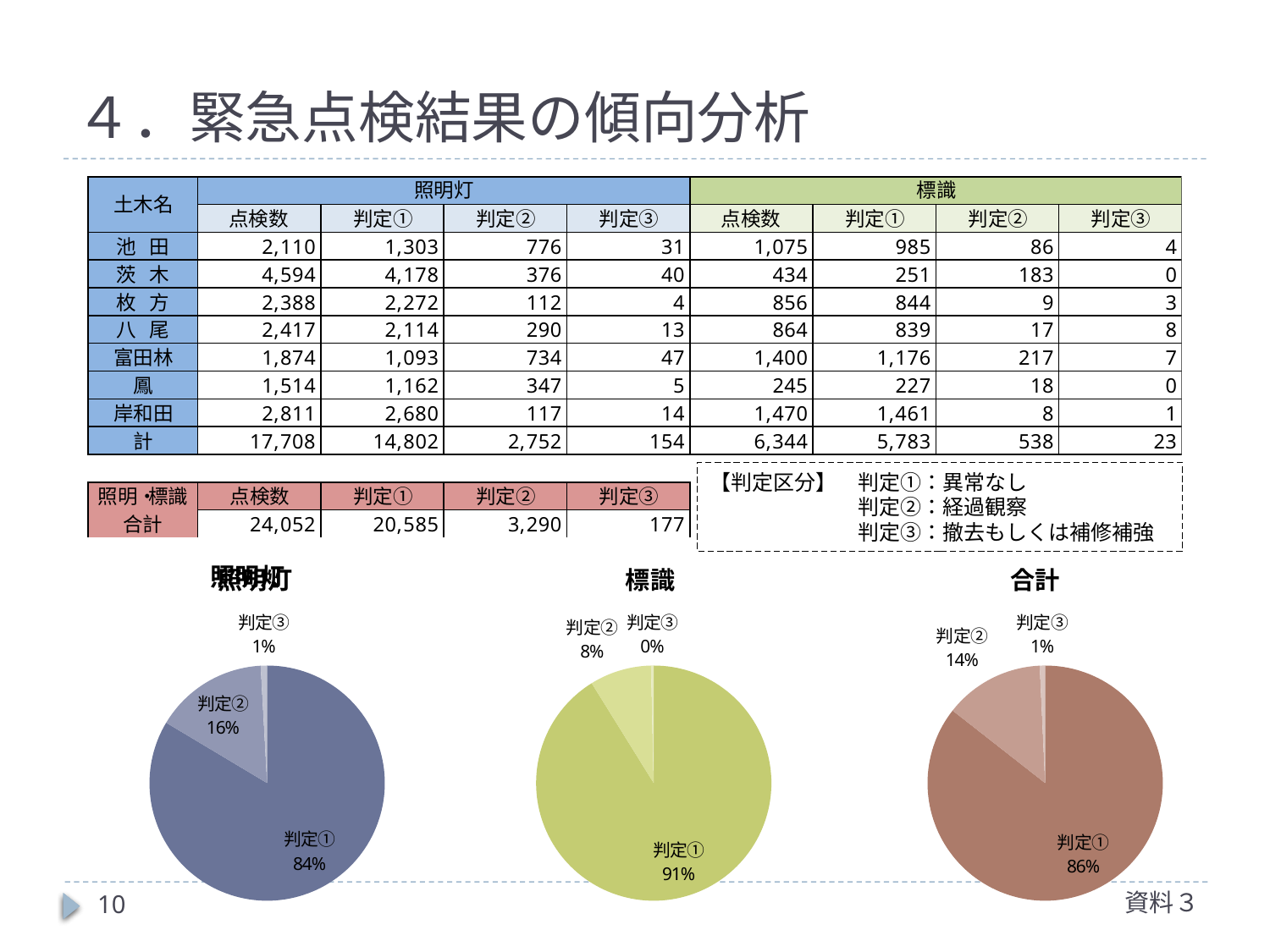
In the 合計 pie chart, what share does 判定① have? 86% In the 合計 pie chart, what share does 判定② have? 14% How many slices does the 合計 pie chart have? 3 Which is larger: the 判定② share in the left pie chart or the 判定② share in the 合計 pie chart? the left pie chart In the left pie chart, what share does 判定① have? 84% What type of chart is used for the three charts at the bottom of the slide? pie chart In the 標識 pie chart, which slice is the smallest? 判定③ In the 合計 pie chart, which slice is the largest? 判定①